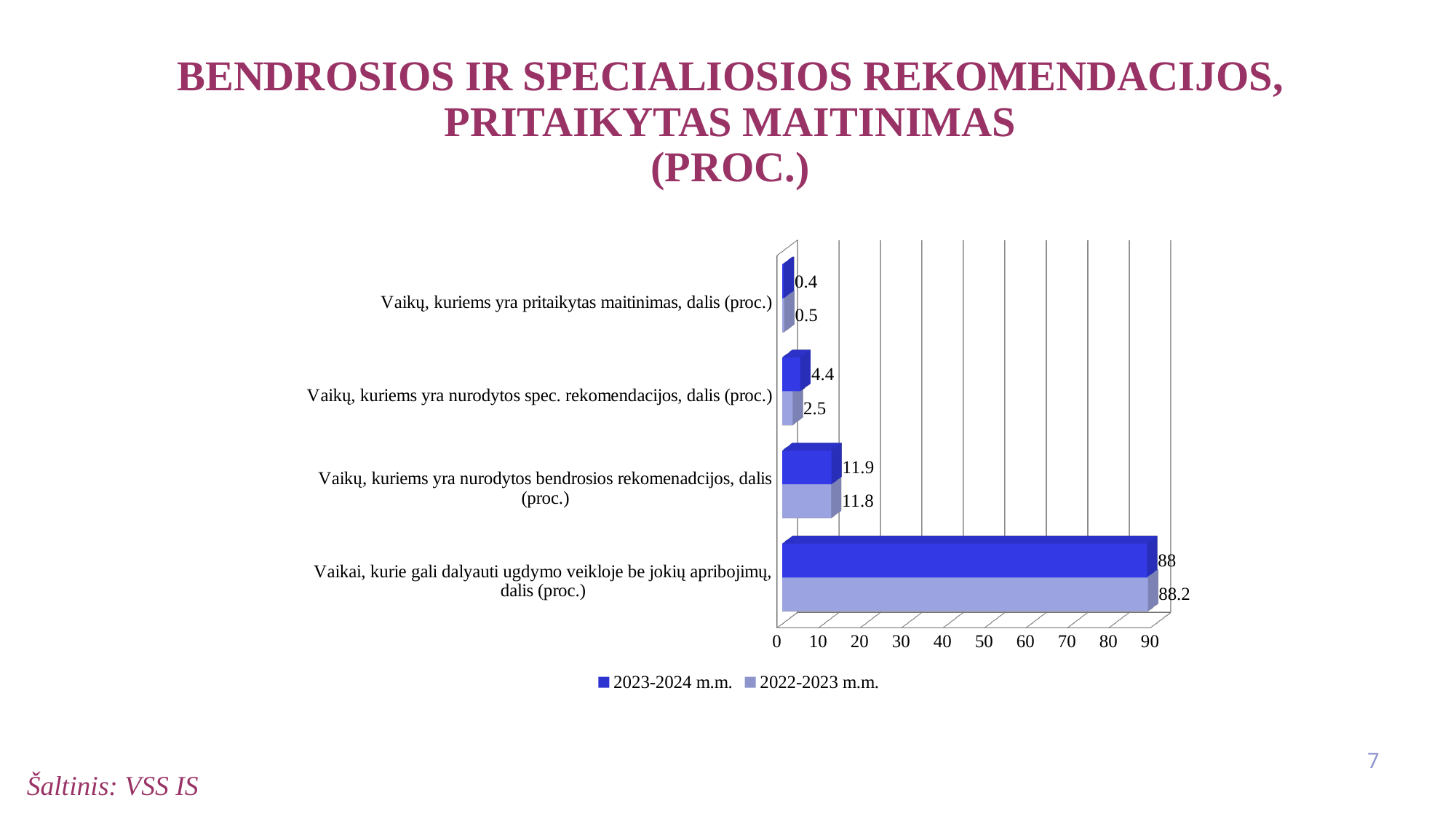
What is the value for 'Vaikų, kuriems yra nurodytos bendrosios rekomenadcijos, dalis (proc.)' in the 2022-2023 m.m. series? 11.8 Which category has the lowest value in the 2023-2024 m.m. series? Vaikų, kuriems yra pritaikytas maitinimas, dalis (proc.) What is the source cited at the bottom of the slide? VSS IS What is the difference between the 2023-2024 m.m. and 2022-2023 m.m. values for 'Vaikų, kuriems yra nurodytos spec. rekomendacijos, dalis (proc.)'? 1.9 How many series does the legend list? 2 What type of chart is shown on the slide? bar chart What is the value for 'Vaikų, kuriems yra nurodytos spec. rekomendacijos, dalis (proc.)' in the 2023-2024 m.m. series? 4.4 For 'Vaikai, kurie gali dalyvauti ugdymo veikloje be jokių apribojimų, dalis (proc.)', which series has the larger value, 2023-2024 m.m. or 2022-2023 m.m.? 2022-2023 m.m. How many categories are shown on the chart? 4 Which category has the highest value in the 2022-2023 m.m. series? Vaikai, kurie gali dalyvauti ugdymo veikloje be jokių apribojimų, dalis (proc.) What is the value for 'Vaikai, kurie gali dalyvauti ugdymo veikloje be jokių apribojimų, dalis (proc.)' in the 2023-2024 m.m. series? 88 What is the value for 'Vaikų, kuriems yra pritaikytas maitinimas, dalis (proc.)' in the 2022-2023 m.m. series? 0.5